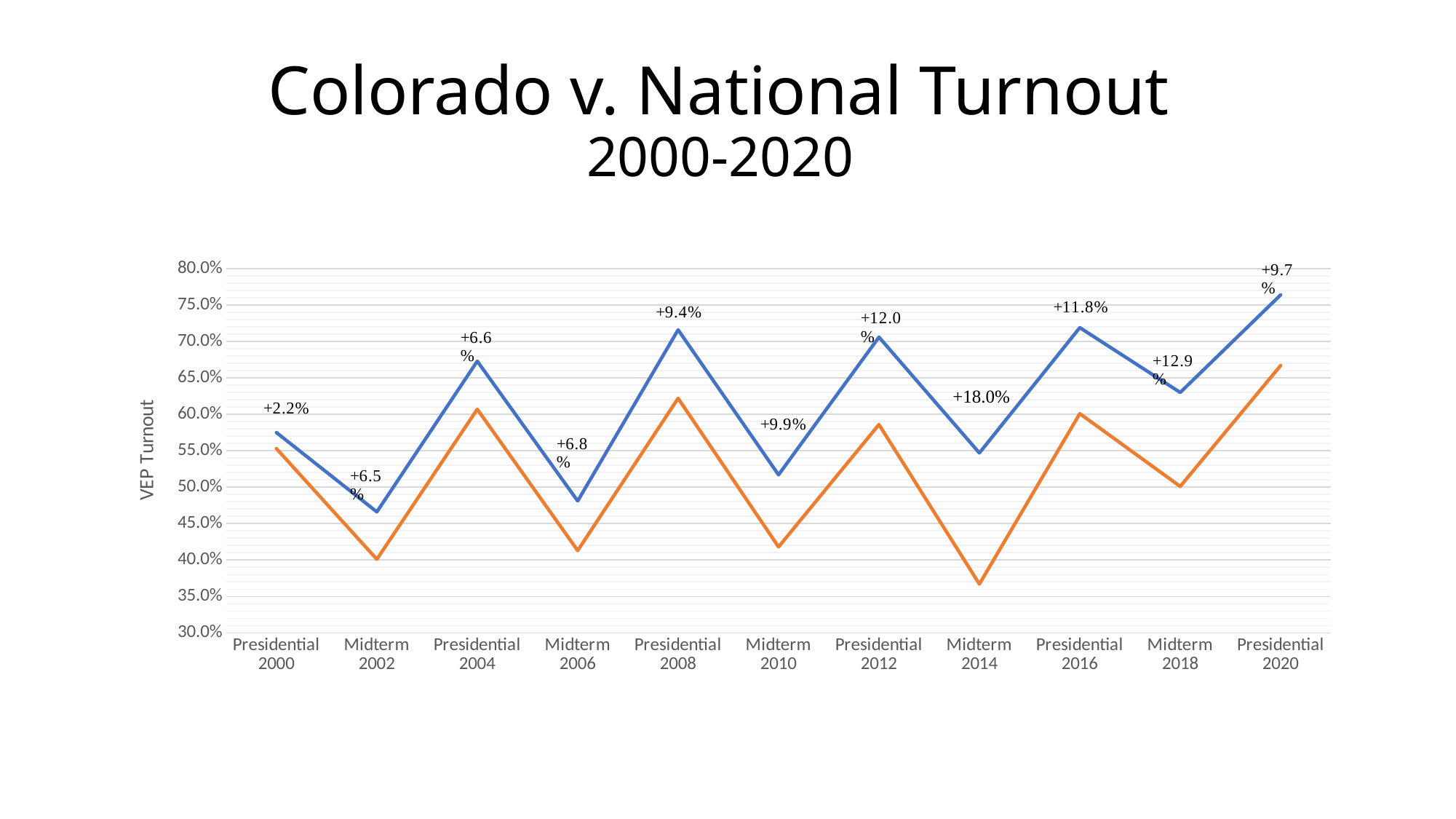
What kind of chart is shown on the slide? line chart Which election has the smallest annotated difference between the two lines? Presidential 2000 Is the value of the blue line at Midterm 2002 greater or less than 50.0%? less What difference is annotated at Presidential 2000? +2.2% What is the label on the vertical axis? VEP Turnout Is the value of the orange line at Midterm 2014 greater or less than 40.0%? less How many elections are plotted along the x axis? 11 What difference is annotated at Presidential 2016? +11.8% At which election does the blue line reach its highest point? Presidential 2020 Which election has the largest annotated difference between the two lines? Midterm 2014 What is the title of the chart? Colorado v. National Turnout 2000-2020 What difference is annotated at Midterm 2014? +18.0%